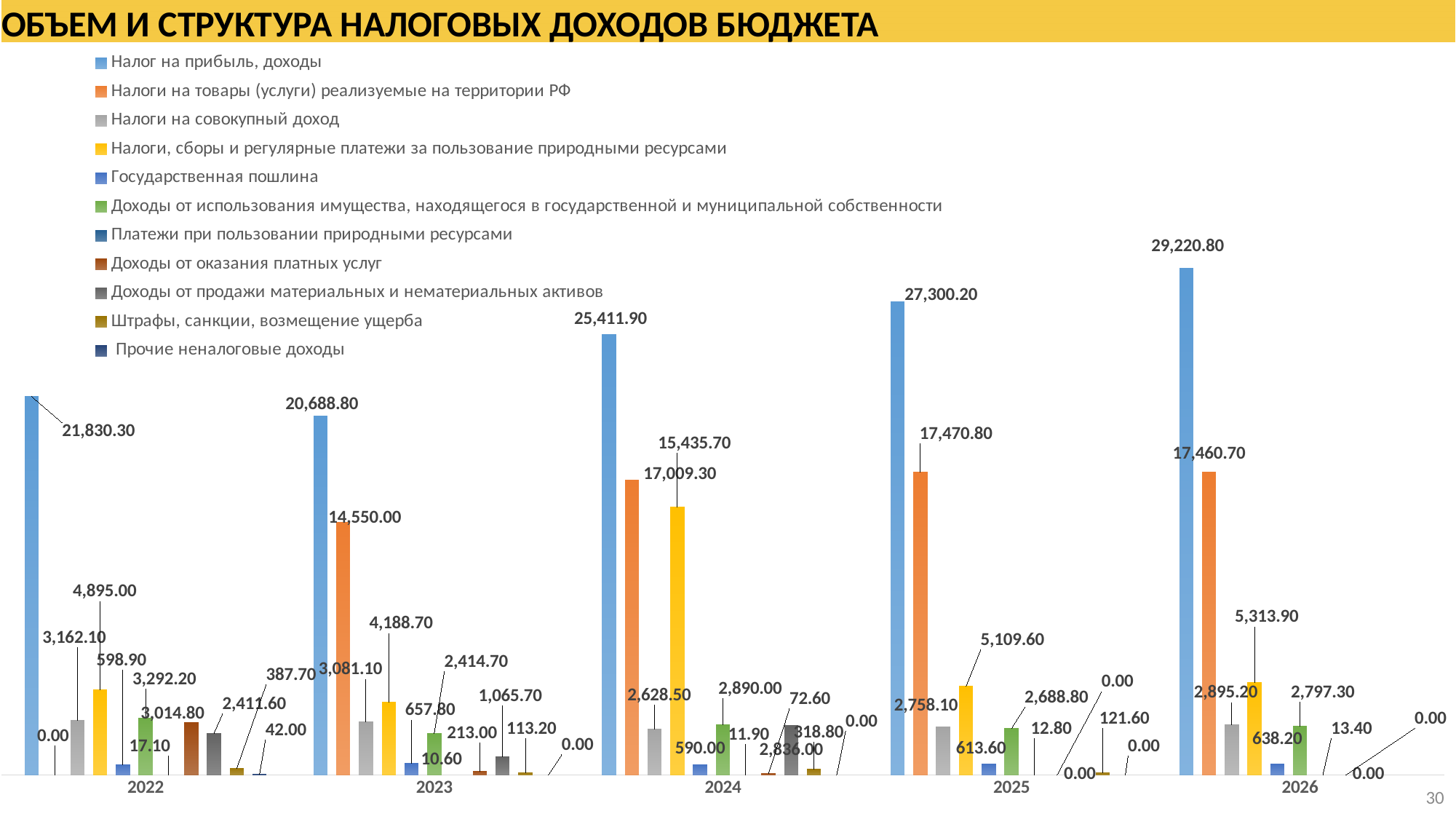
Does 'Налог на прибыль, доходы' rise or fall from 2023 to 2026? Rise What is the value of 'Налог на прибыль, доходы' in 2026? 29,220.80 Which is larger in 2026: 'Налог на прибыль, доходы' or 'Налоги на товары (услуги) реализуемые на территории РФ'? Налог на прибыль, доходы In which year is 'Налог на прибыль, доходы' the lowest? 2023 How many years are shown on the x axis? 5 What is the title of the chart on the slide? ОБЪЕМ И СТРУКТУРА НАЛОГОВЫХ ДОХОДОВ БЮДЖЕТА In which year is 'Налог на прибыль, доходы' the highest? 2026 What is the difference between 'Налог на прибыль, доходы' in 2026 and in 2025? 1,920.60 What type of chart is shown on the slide? Bar chart What is the value of 'Налоги на товары (услуги) реализуемые на территории РФ' in 2024? 17,009.30 How many series does the legend list? 11 What is the value of 'Налог на прибыль, доходы' in 2023? 20,688.80